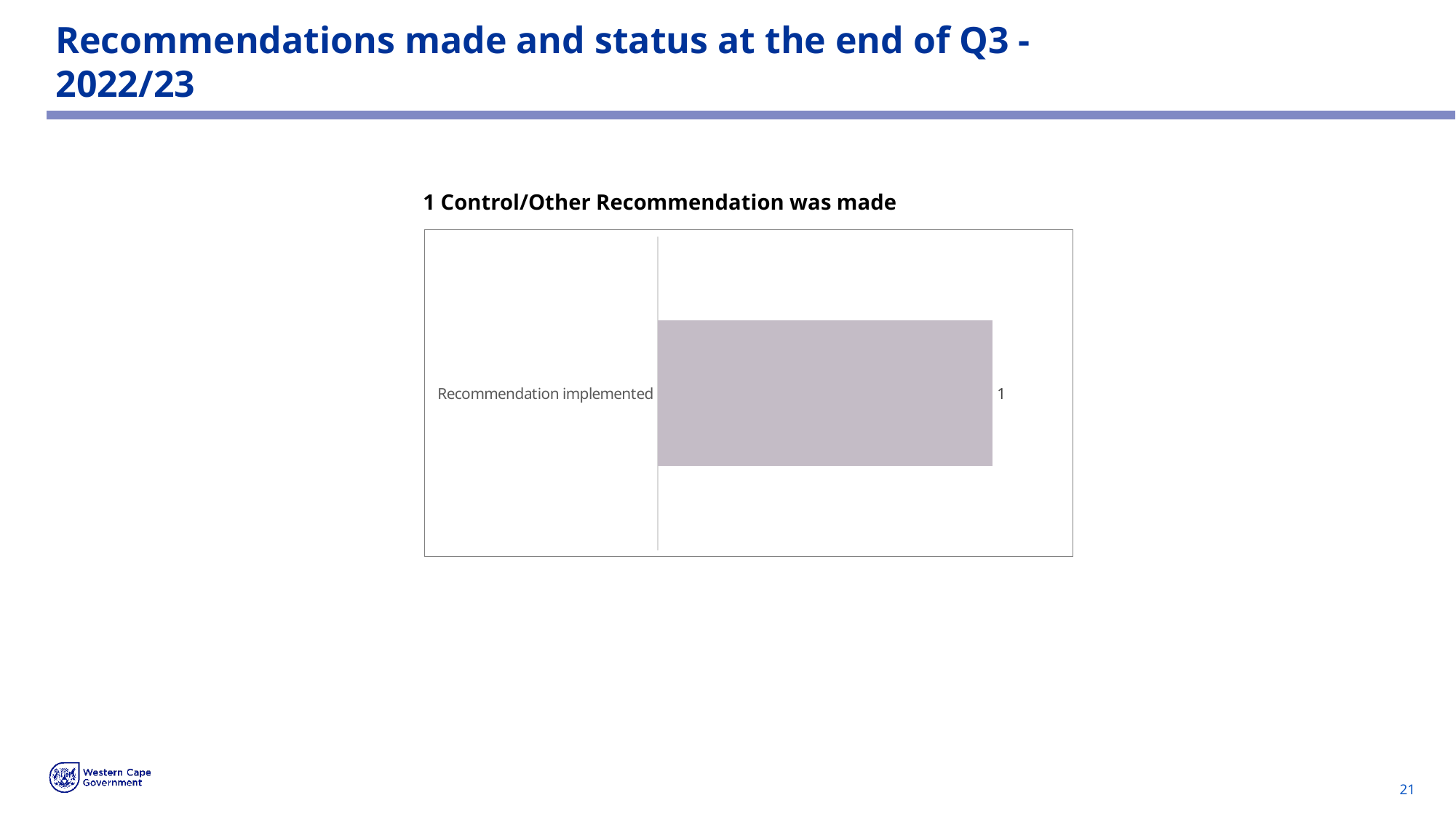
What is the title of the chart? 1 Control/Other Recommendation was made How many categories are plotted in the chart? 1 What kind of chart is shown on the slide? bar chart Which category has the highest value in the chart? Recommendation implemented What is the value for Recommendation implemented? 1 What is the label of the only category shown in the chart? Recommendation implemented